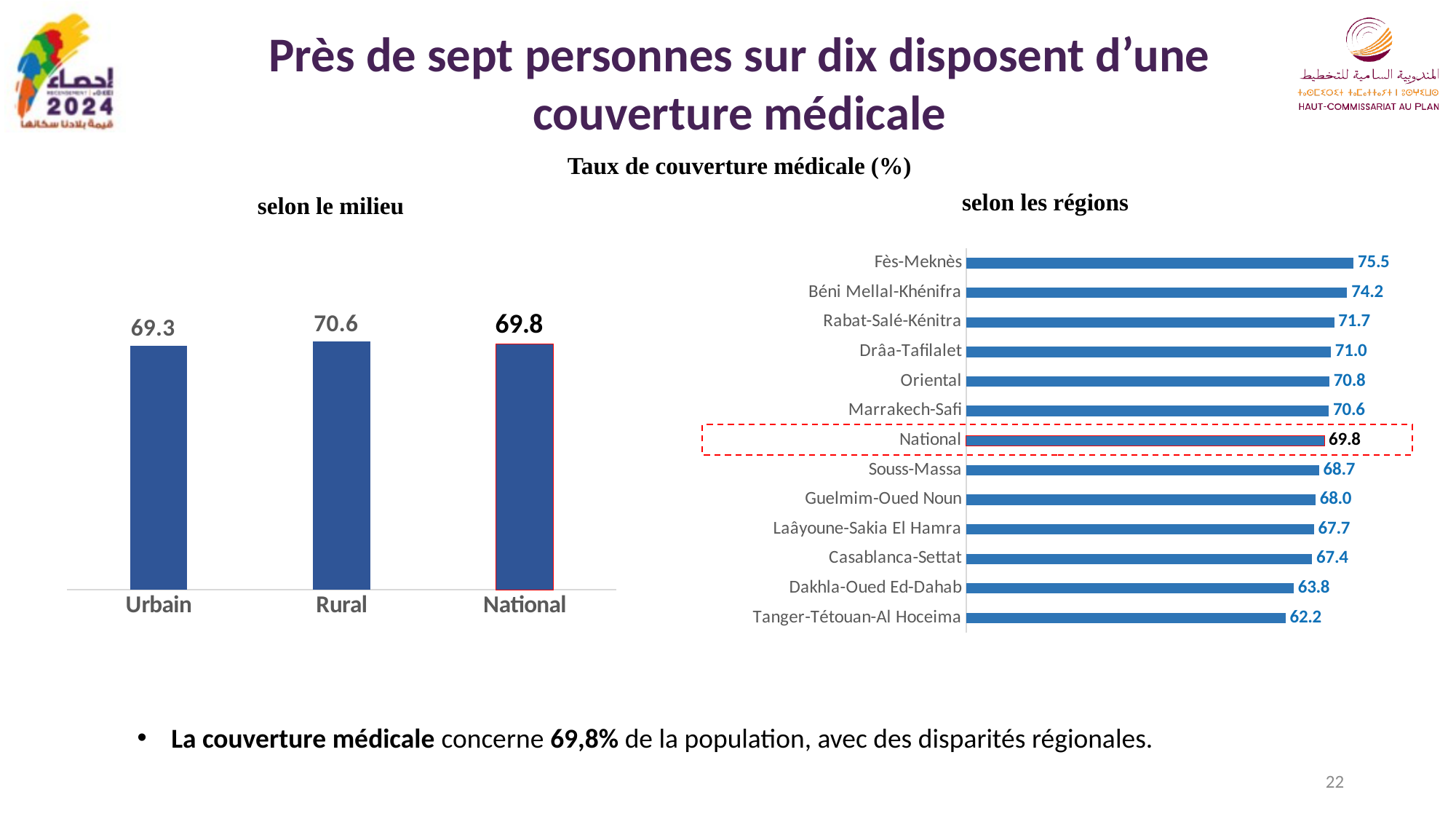
What kind of chart is the 'selon les régions' chart? Bar chart In the 'selon les régions' chart, which region has the lowest value? Tanger-Tétouan-Al Hoceima In the 'selon le milieu' chart, what is the difference between the Rural and Urbain values? 1.3 In the 'selon les régions' chart, what is the value for Casablanca-Settat? 67.4 In the 'selon le milieu' chart, how many bars are shown? 3 In the 'selon les régions' chart, which is larger, Souss-Massa or Dakhla-Oued Ed-Dahab? Souss-Massa In the 'selon le milieu' chart, what is the value for Urbain? 69.3 In the 'selon les régions' chart, what is the value for Oriental? 70.8 In the 'selon les régions' chart, which region has the highest value? Fès-Meknès In the 'selon le milieu' chart, what is the value for Rural? 70.6 In the 'selon le milieu' chart, which category has the highest value? Rural In the 'selon les régions' chart, what is the difference between Fès-Meknès and Tanger-Tétouan-Al Hoceima? 13.3